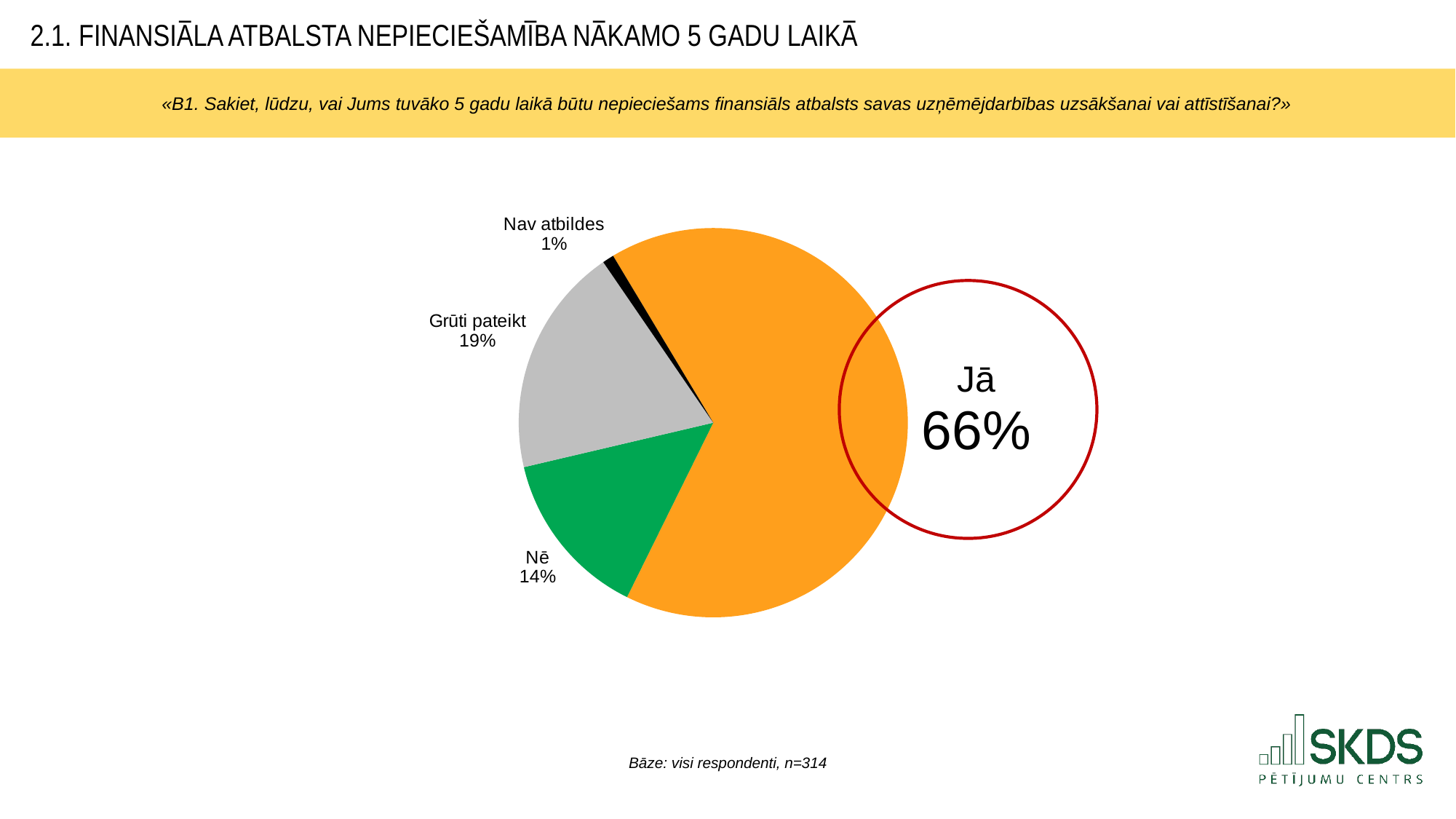
What kind of chart is shown on the slide? Pie chart What is the difference in percentage points between "Jā" and "Nē"? 52 Which answer category has the smallest share of the pie? Nav atbildes What share of respondents answered "Nē"? 14% What share of respondents gave no answer ("Nav atbildes")? 1% What is the base (number of respondents) stated below the chart? n=314 What share of respondents answered "Grūti pateikt"? 19% How many slices does the pie chart have? 4 Which is larger, the share for "Grūti pateikt" or the share for "Nē"? Grūti pateikt Which answer category has the largest share of the pie? Jā What share of respondents answered "Jā"? 66% What colour is the "Nē" slice of the pie? Green